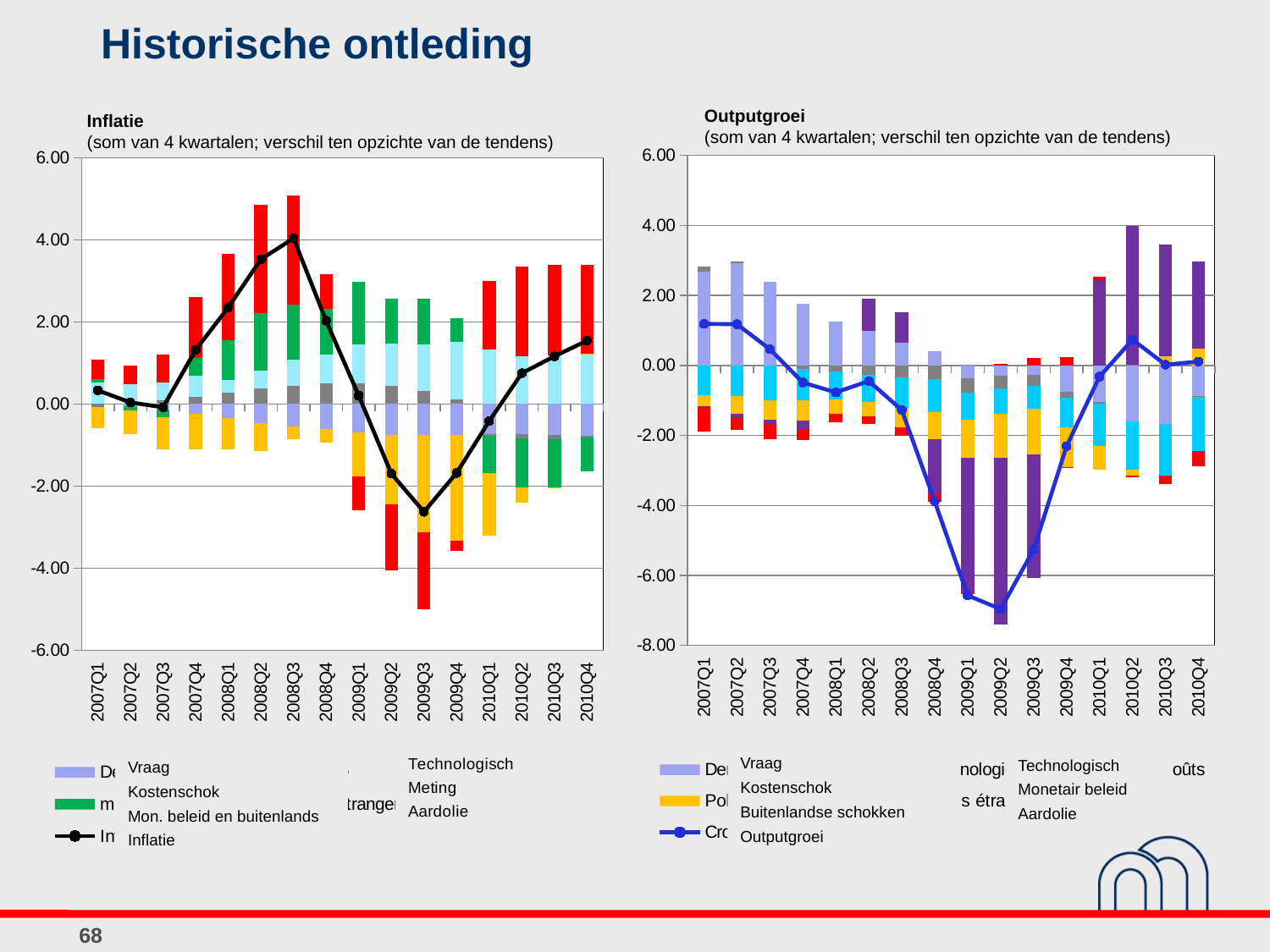
In the Inflatie chart, is the value of the Inflatie line for 2009Q3 greater or less than -2.00? less In the Inflatie chart, which is larger: the Inflatie line value for 2008Q3 or for 2009Q3? 2008Q3 In the Inflatie chart, does the Inflatie line rise or fall from 2007Q3 to 2008Q3? rise What colour is the Outputgroei line in the Outputgroei chart? Blue In the Outputgroei chart, does the Outputgroei line rise or fall from 2007Q2 to 2009Q2? fall In the Inflatie chart, in which quarter does the Inflatie line reach its lowest value? 2009Q3 In the Outputgroei chart, in which quarter does the Outputgroei line reach its lowest value? 2009Q2 How many quarters are shown on the x axis of the Outputgroei chart? 16 In the Outputgroei chart, is the value of the Outputgroei line for 2009Q2 greater or less than -6.00? less In the Inflatie chart, in which quarter does the Inflatie line reach its highest value? 2008Q3 In the Inflatie chart, is the value of the Inflatie line for 2008Q3 greater or less than 2.00? greater What kind of chart is the Outputgroei chart? Stacked bar chart with a line